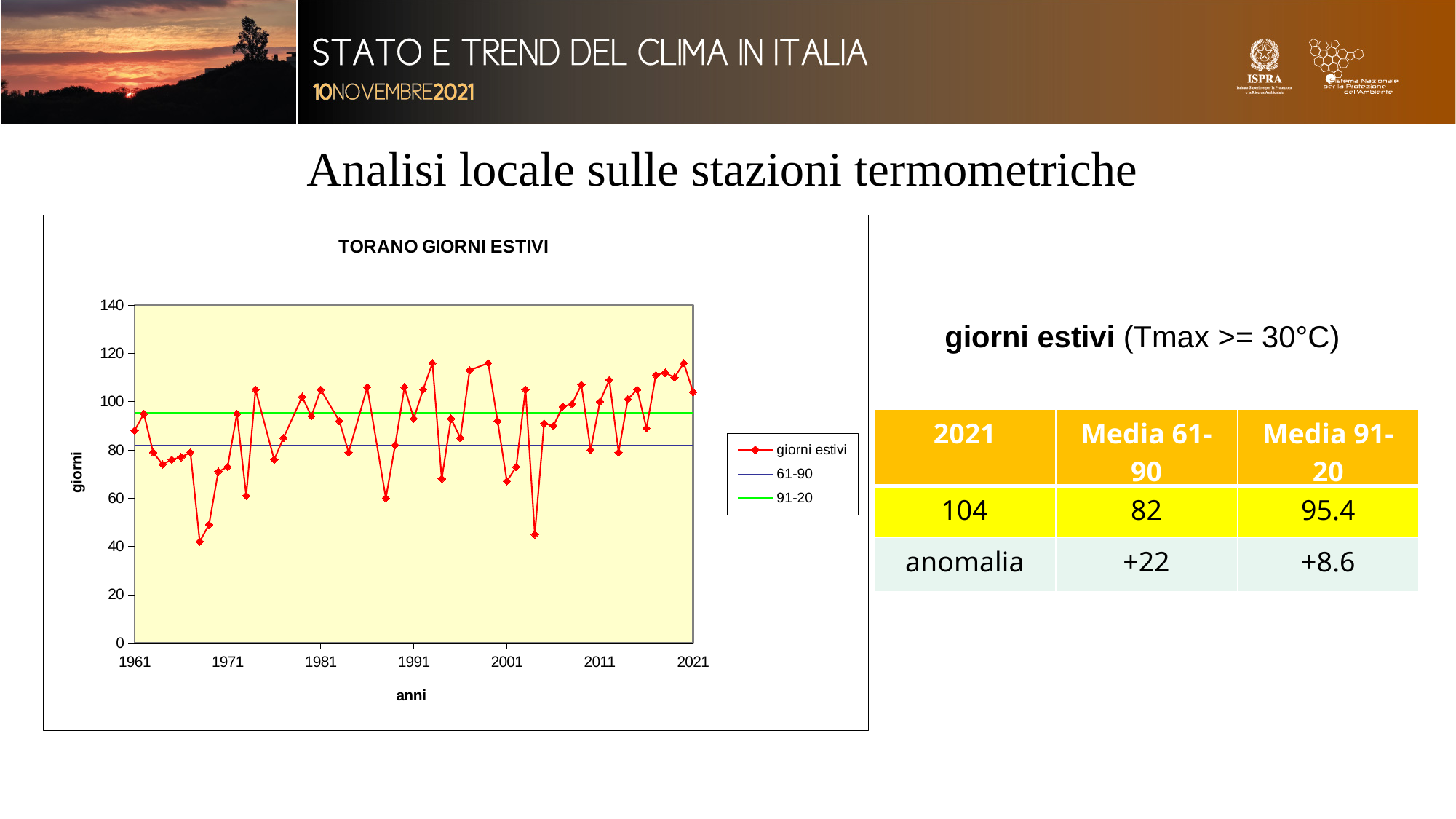
How many series does the chart legend list? 3 Which reference line is higher, 61-90 or 91-20? 91-20 What is the label of the y axis? giorni Is the value of giorni estivi for 1961 greater or less than 80? greater By how much does the 2021 value of giorni estivi exceed the 61-90 mean? 22 What is the title of the chart? TORANO GIORNI ESTIVI What kind of chart is shown on the slide? line chart What value does the 91-20 reference line represent? 95.4 What value does the 61-90 reference line represent? 82 Is the value of giorni estivi for 2001 greater or less than 80? less What is the value of giorni estivi for 2021? 104